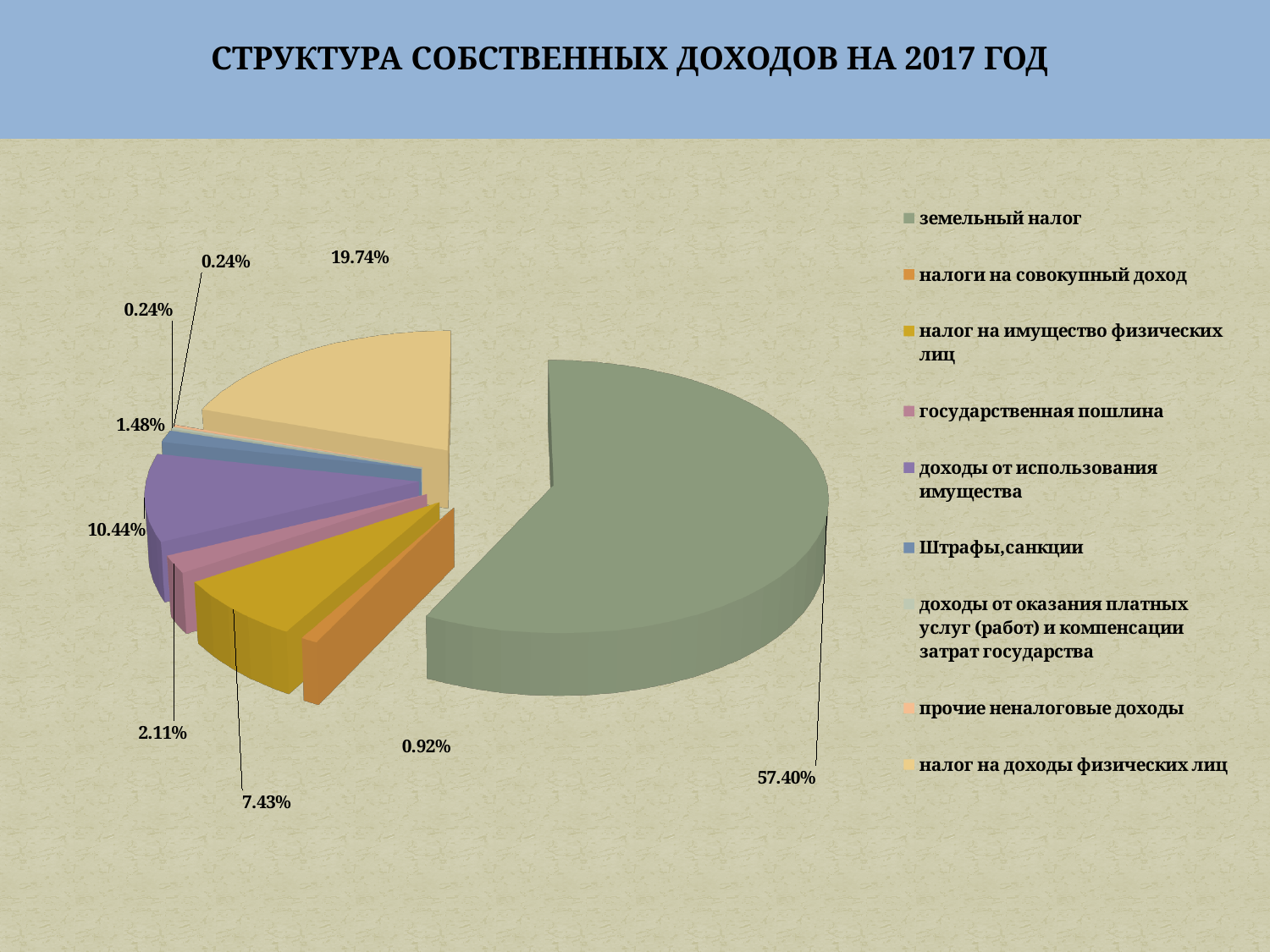
Which category has the largest share of the pie? земельный налог What is the title of the chart? СТРУКТУРА СОБСТВЕННЫХ ДОХОДОВ НА 2017 ГОД What is the difference between the shares of земельный налог and налог на доходы физических лиц? 37.66% What share of the pie is налог на доходы физических лиц? 19.74% What share of the pie is земельный налог? 57.40% Which is larger: государственная пошлина or налоги на совокупный доход? государственная пошлина What share of the pie is Штрафы,санкции? 1.48% What colour is the slice for земельный налог? green How many categories does the legend list? 9 What kind of chart is shown on the slide? pie chart What share of the pie is налог на имущество физических лиц? 7.43% What share of the pie is доходы от использования имущества? 10.44%